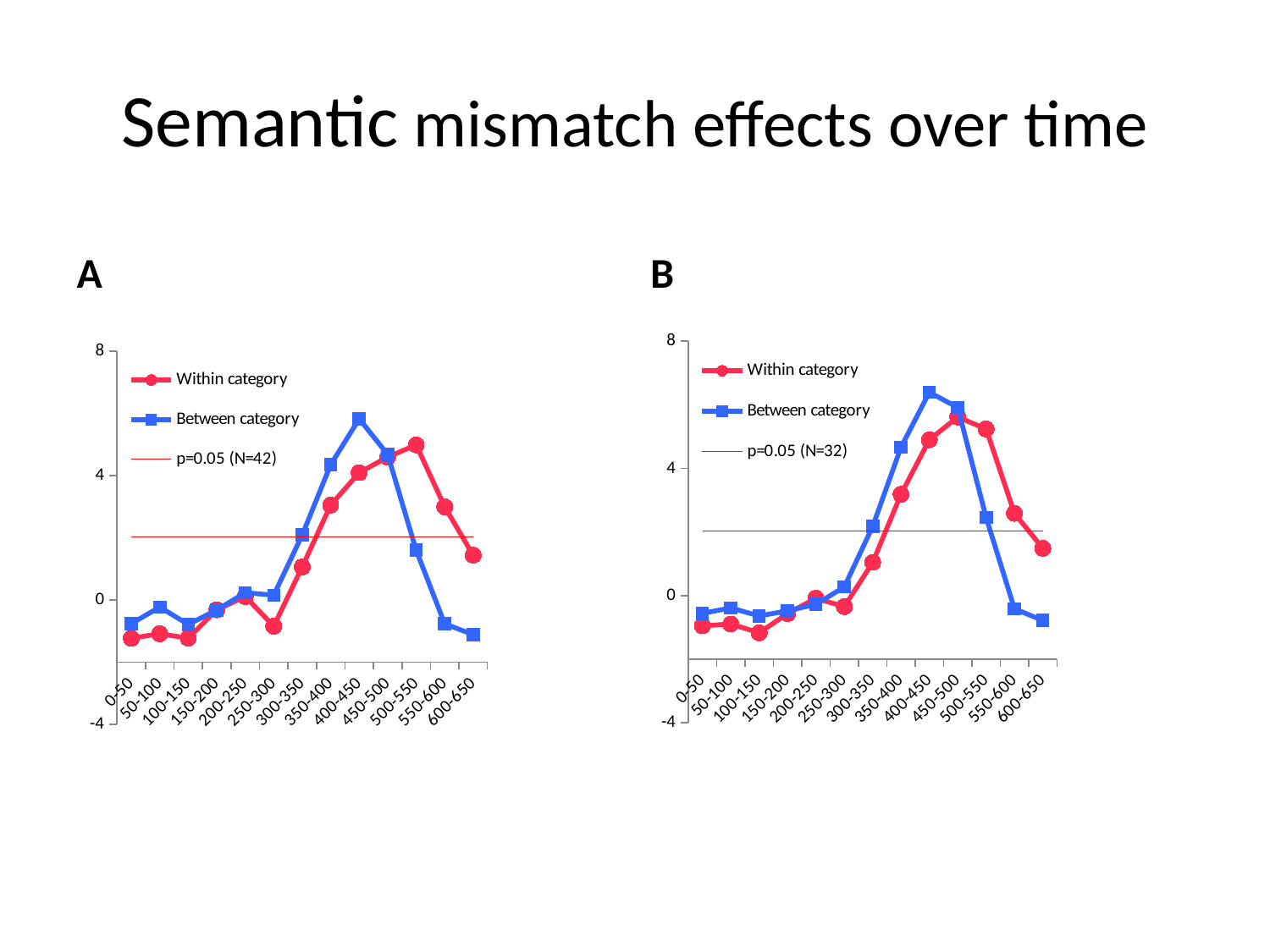
What kind of chart is chart A? Line chart In chart A, at which time bin does the Within category line reach its highest value? 500-550 What is the third legend entry in chart B? p=0.05 (N=32) In chart B, at 550-600, which series has the larger value, Within category or Between category? Within category In chart A, is the Between category value at 400-450 greater or less than 4? greater How many time bins are shown on the x axis of chart B? 13 How many entries does the legend of chart A list? 3 In chart A, at which time bin does the Between category line reach its highest value? 400-450 In chart A, at 550-600, which series has the larger value, Within category or Between category? Within category In chart B, at which time bin does the Between category line reach its highest value? 400-450 In chart B, is the Between category value at 600-650 greater or less than 0? less In chart A, does the Between category line rise or fall from 400-450 to 600-650? Fall